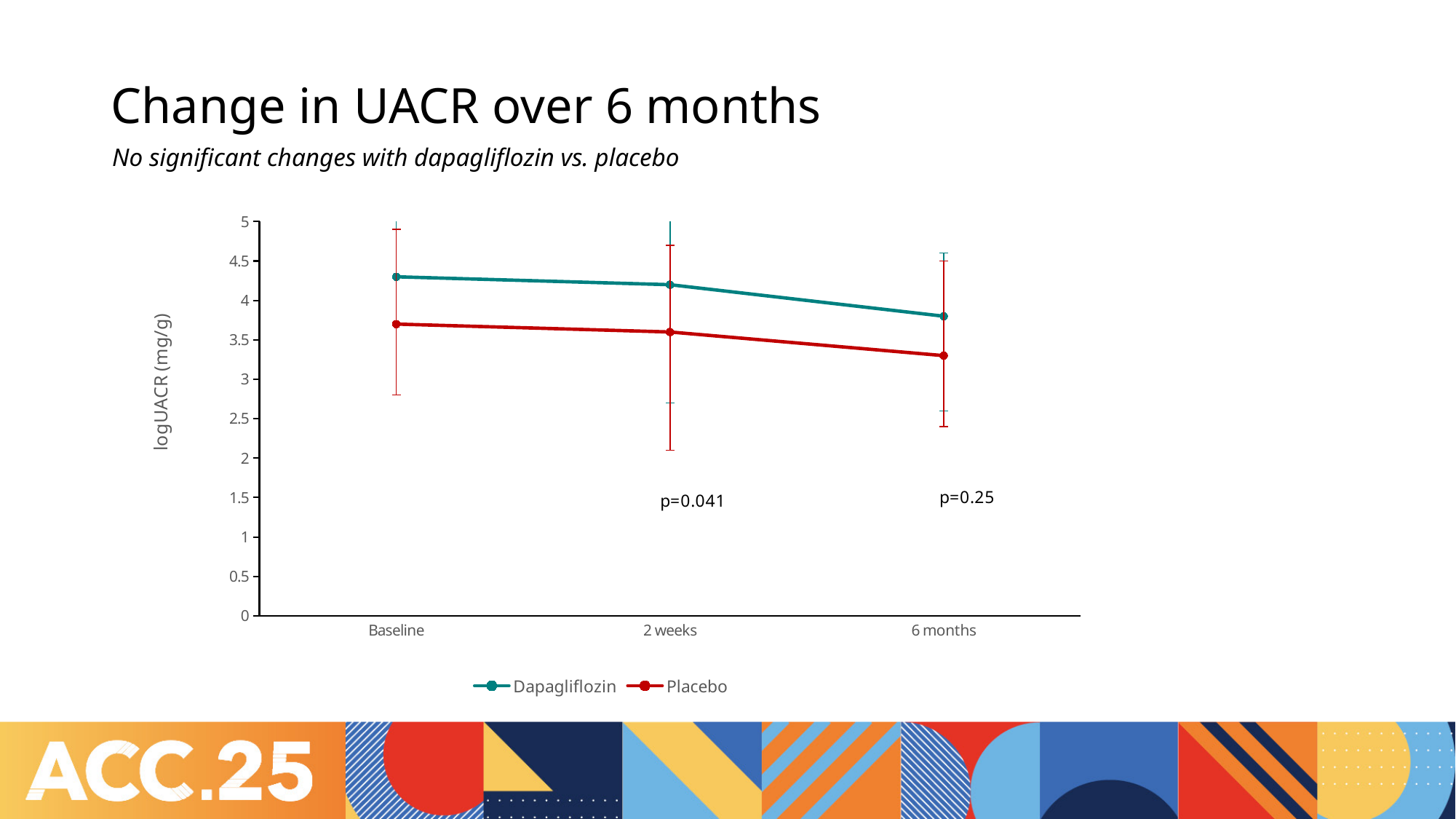
What p-value is printed at the 2 weeks time point? p=0.041 At which time point is the Placebo value lowest? 6 months Is the Placebo value at 6 months greater or less than 3.5? less How many time points are plotted along the x axis? 3 Do the Dapagliflozin values rise or fall from Baseline to 6 months? fall What kind of chart is shown on the slide? line chart How many series does the legend list? 2 Is the Placebo value at Baseline greater or less than 3.5? greater Which series has the higher logUACR value at Baseline, Dapagliflozin or Placebo? Dapagliflozin Which series has the lower logUACR value at 6 months? Placebo Is the Dapagliflozin value at Baseline greater or less than 4? greater